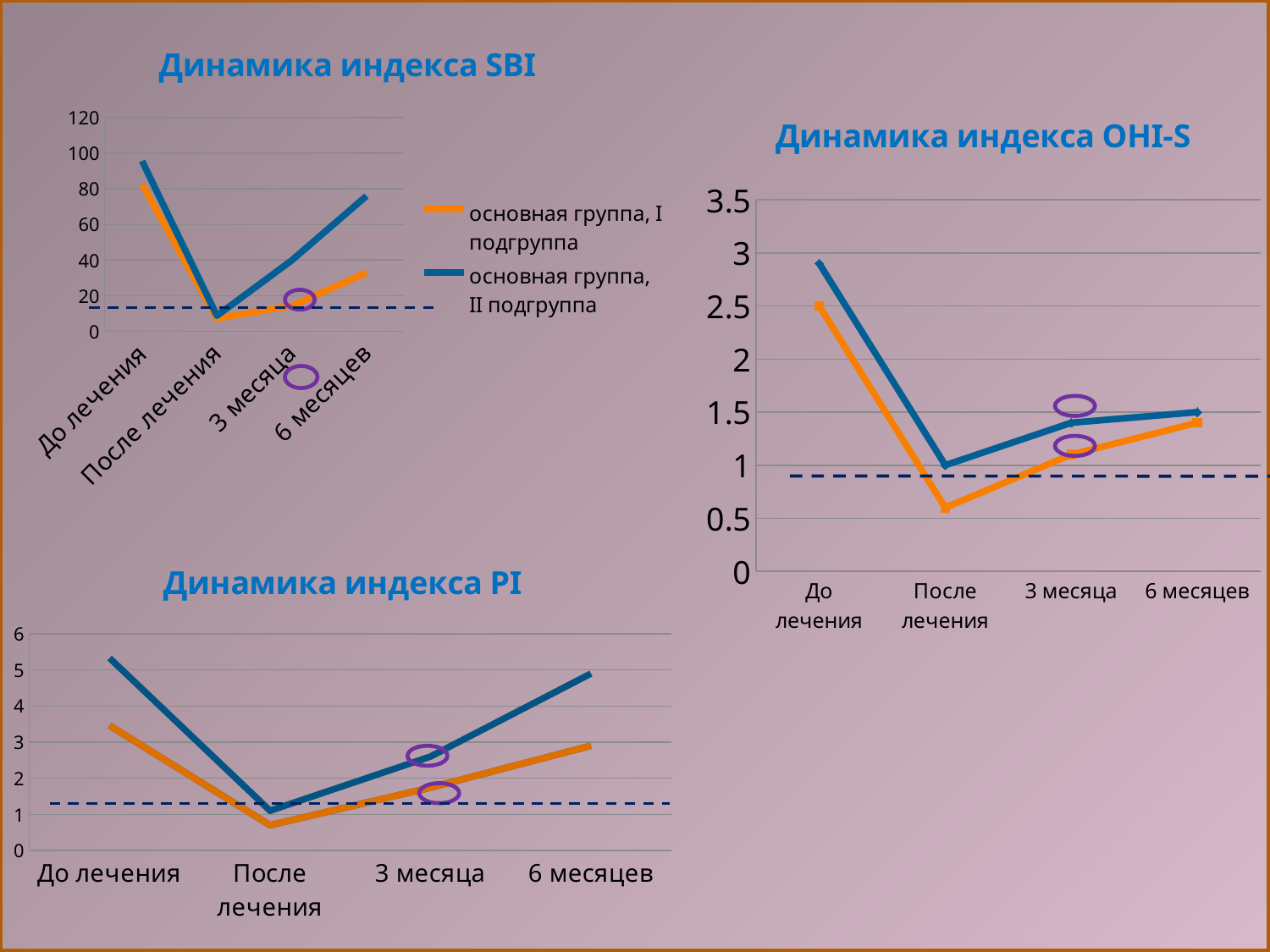
In the 'Динамика индекса SBI' chart, how many categories are on the x axis? 4 In the 'Динамика индекса OHI-S' chart, at which category is 'основная группа, I подгруппа' lowest? После лечения In the 'Динамика индекса SBI' chart, how many series does the legend list? 2 In the 'Динамика индекса OHI-S' chart, is the value for 'основная группа, I подгруппа' at 'После лечения' greater or less than 1? less In the 'Динамика индекса SBI' chart, is the value for 'основная группа, II подгруппа' at 'До лечения' greater or less than 80? greater In the 'Динамика индекса SBI' chart, is the value for 'основная группа, I подгруппа' at '6 месяцев' greater or less than 40? less What kind of chart is 'Динамика индекса SBI'? line chart In the 'Динамика индекса PI' chart, do the values for 'основная группа, II подгруппа' rise or fall from 'После лечения' to '6 месяцев'? rise In the 'Динамика индекса SBI' chart, which series has the higher value at '6 месяцев'? основная группа, II подгруппа In the 'Динамика индекса PI' chart, which series has the higher value at '6 месяцев'? основная группа, II подгруппа